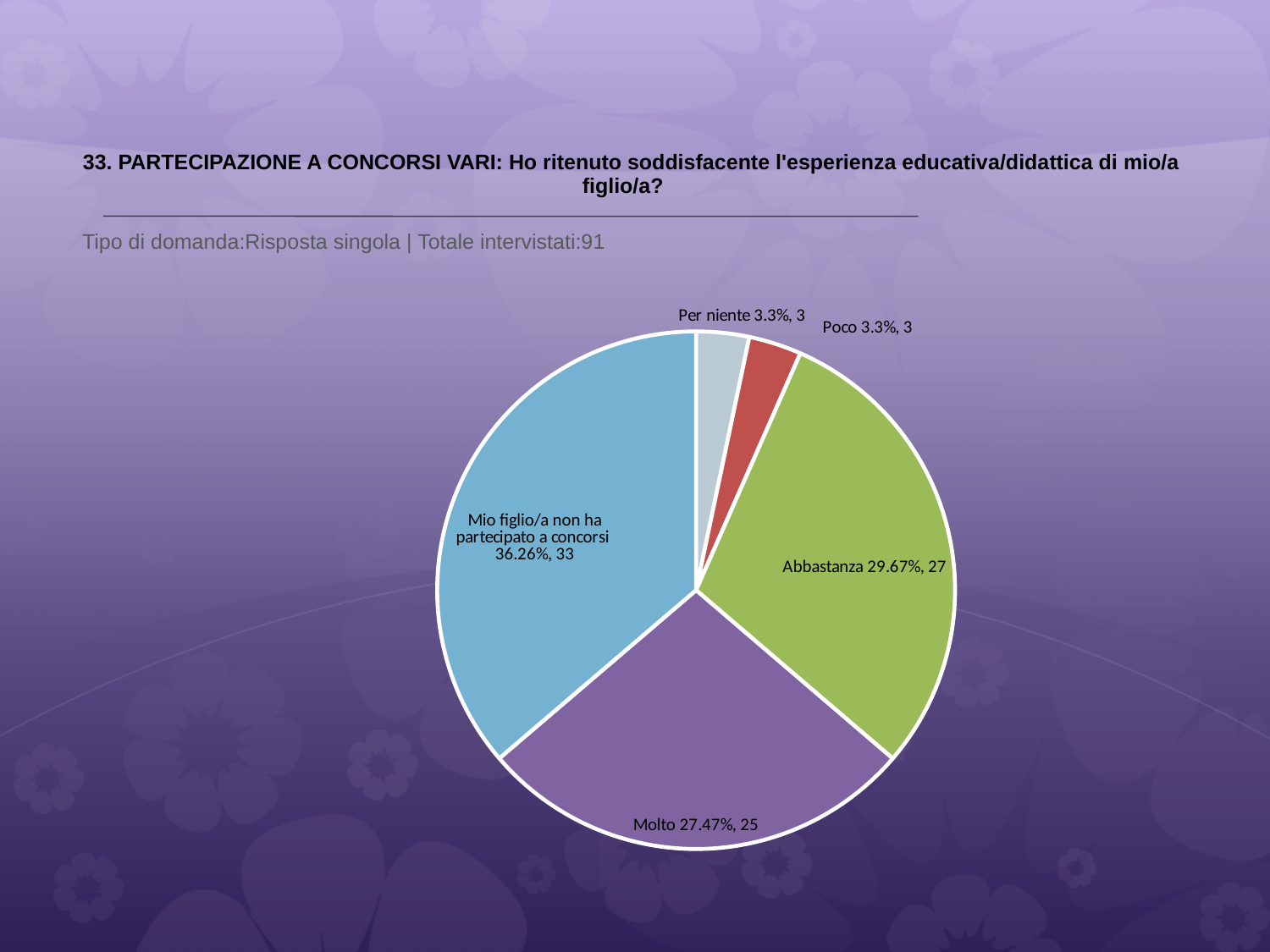
Which is larger, the count for "Molto" or the count for "Mio figlio/a non ha partecipato a concorsi"? Mio figlio/a non ha partecipato a concorsi What is the count for "Mio figlio/a non ha partecipato a concorsi"? 33 What is the difference in count between "Mio figlio/a non ha partecipato a concorsi" and "Abbastanza"? 6 What percentage share does "Per niente" have? 3.3% What is the count for "Poco"? 3 What is the total number of respondents stated on the slide? 91 What is the difference in count between "Abbastanza" and "Molto"? 2 What percentage share does "Molto" have? 27.47% What kind of chart is shown on the slide? pie chart How many slices does the pie chart have? 5 What is the count for "Abbastanza"? 27 Which category has the largest slice? Mio figlio/a non ha partecipato a concorsi